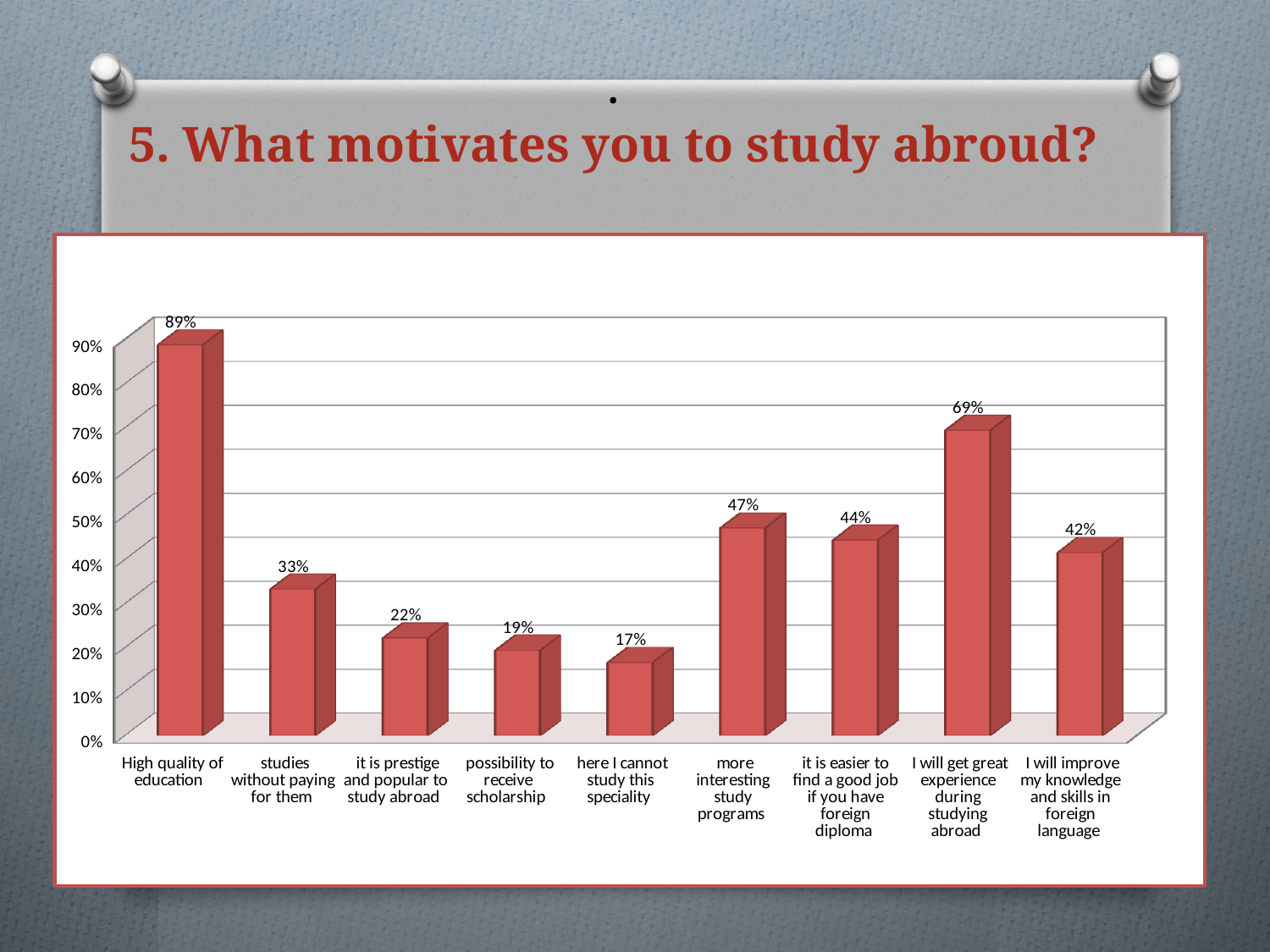
What percentage is shown for 'High quality of education'? 89% What is the value for 'I will get great experience during studying abroad'? 69% Which category has the lowest value? here I cannot study this speciality How many categories are shown in the chart? 9 What is the title of the slide? 5. What motivates you to study abroud? What colour are the bars in the chart? red What is the difference between 'High quality of education' and 'I will get great experience during studying abroad'? 20% What is the difference between 'more interesting study programs' and 'it is easier to find a good job if you have foreign diploma'? 3% What percentage is shown for 'possibility to receive scholarship'? 19% Which is larger: 'studies without paying for them' or 'I will improve my knowledge and skills in foreign language'? I will improve my knowledge and skills in foreign language Which category has the highest value? High quality of education What kind of chart is shown on the slide? bar chart